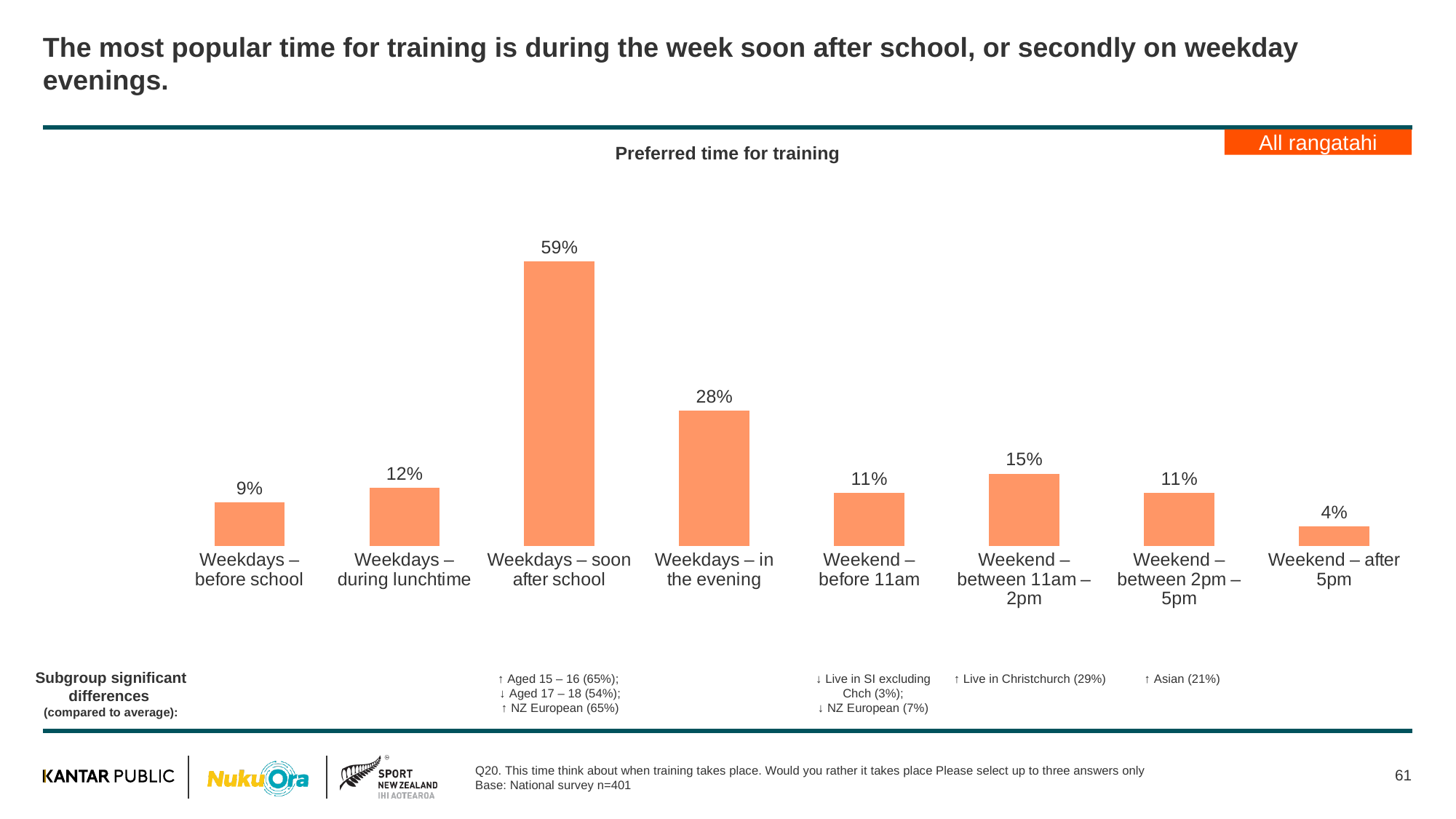
Which preferred training time has the highest value? Weekdays – soon after school What is the title of the chart? Preferred time for training Which is larger: 'Weekend – between 11am – 2pm' or 'Weekend – before 11am'? Weekend – between 11am – 2pm What is the value for 'Weekdays – in the evening'? 28% What is the value for 'Weekend – between 11am – 2pm'? 15% What percentage of rangatahi prefer training on weekdays soon after school? 59% What percentage prefer training on the weekend after 5pm? 4% What is the difference between 'Weekdays – during lunchtime' and 'Weekdays – before school'? 3 percentage points How many preferred training time categories are shown in the chart? 8 What is the difference between 'Weekdays – soon after school' and 'Weekdays – in the evening'? 31 percentage points Which preferred training time has the lowest value? Weekend – after 5pm What type of chart is used to show preferred time for training? Bar chart